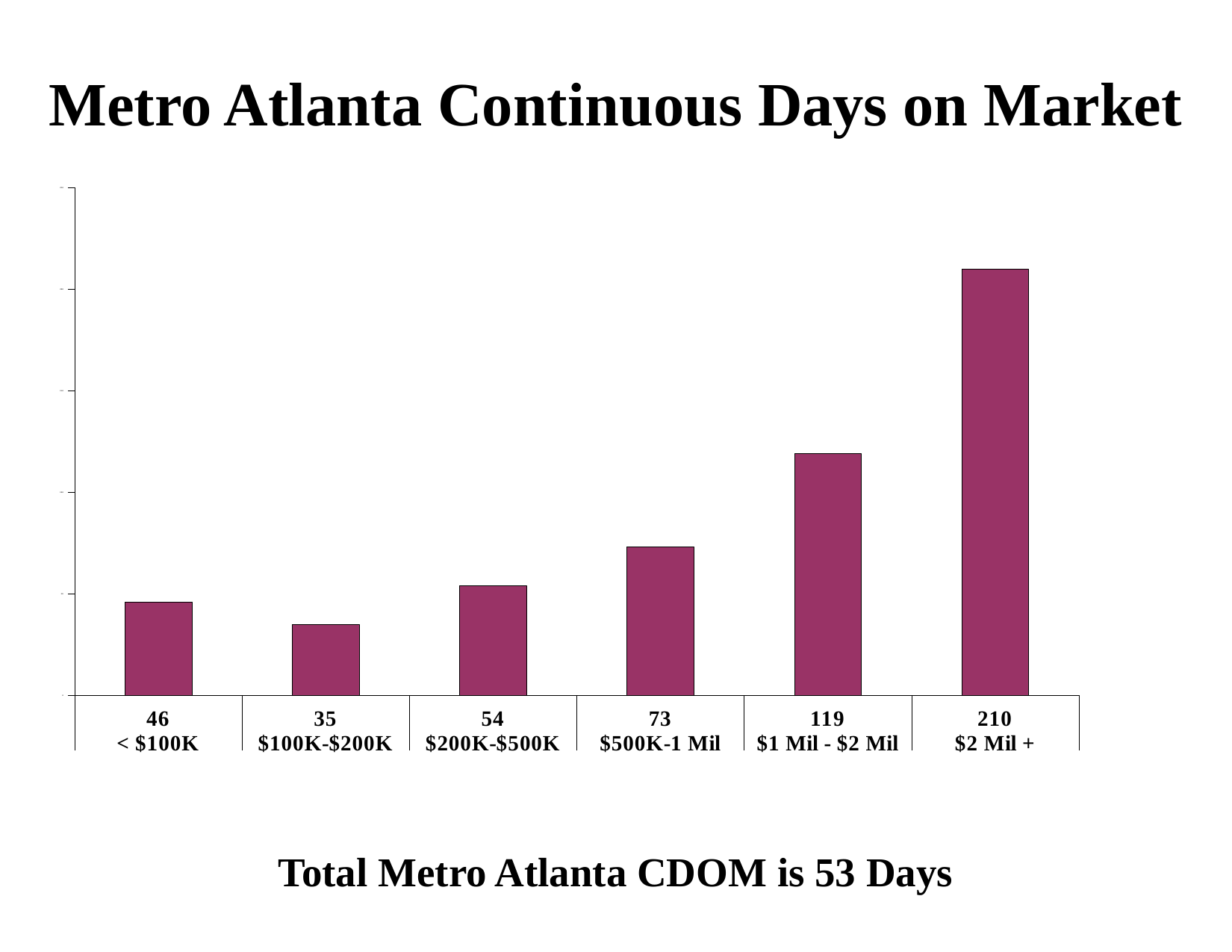
What is the title of the chart on the slide? Metro Atlanta Continuous Days on Market From the $100K-$200K range to the $2 Mil + range, do the days on market values rise or fall? Rise Which has more continuous days on market, < $100K or $200K-$500K? $200K-$500K How many price range categories are shown in the chart? 6 Which price range has the lowest continuous days on market? $100K-$200K What is the difference in days on market between the $1 Mil - $2 Mil range and the $200K-$500K range? 65 What type of chart is shown on the slide? Bar chart What is the continuous days on market value for the $500K-1 Mil price range? 73 What is the continuous days on market value for the $2 Mil + price range? 210 Which price range has the highest continuous days on market? $2 Mil + What is the difference in days on market between the $2 Mil + range and the $1 Mil - $2 Mil range? 91 What is the continuous days on market value for the $100K-$200K price range? 35